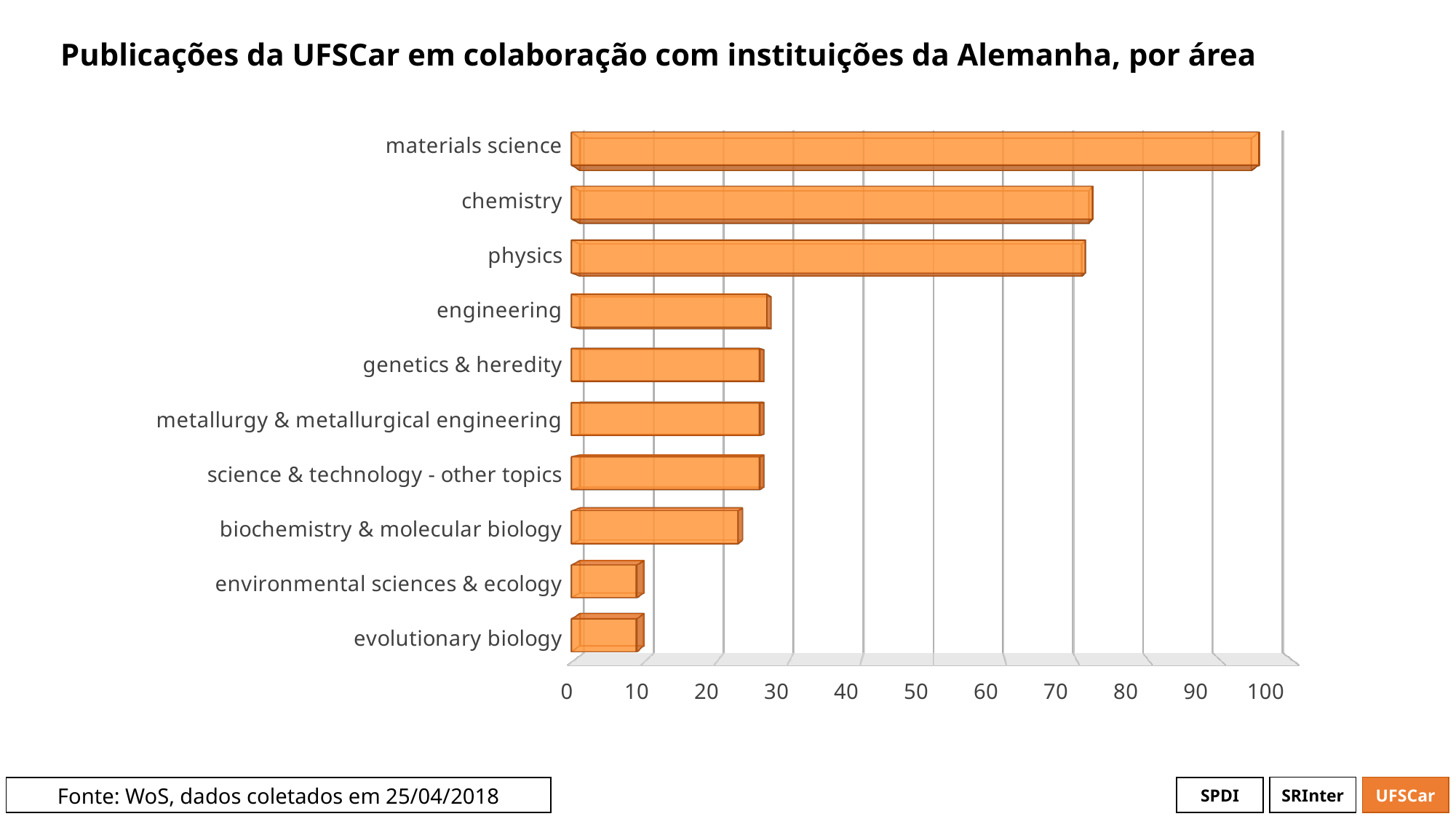
How many areas (categories) are shown in the chart? 10 Is the value for materials science greater or less than 90? greater Is the value for chemistry greater or less than 70? greater What is the title of the chart? Publicações da UFSCar em colaboração com instituições da Alemanha, por área Is the value for engineering greater or less than 30? less What kind of chart is shown on the slide? bar chart Which has more publications, materials science or chemistry? materials science Which has more publications, engineering or biochemistry & molecular biology? engineering Which area has the highest number of publications? materials science